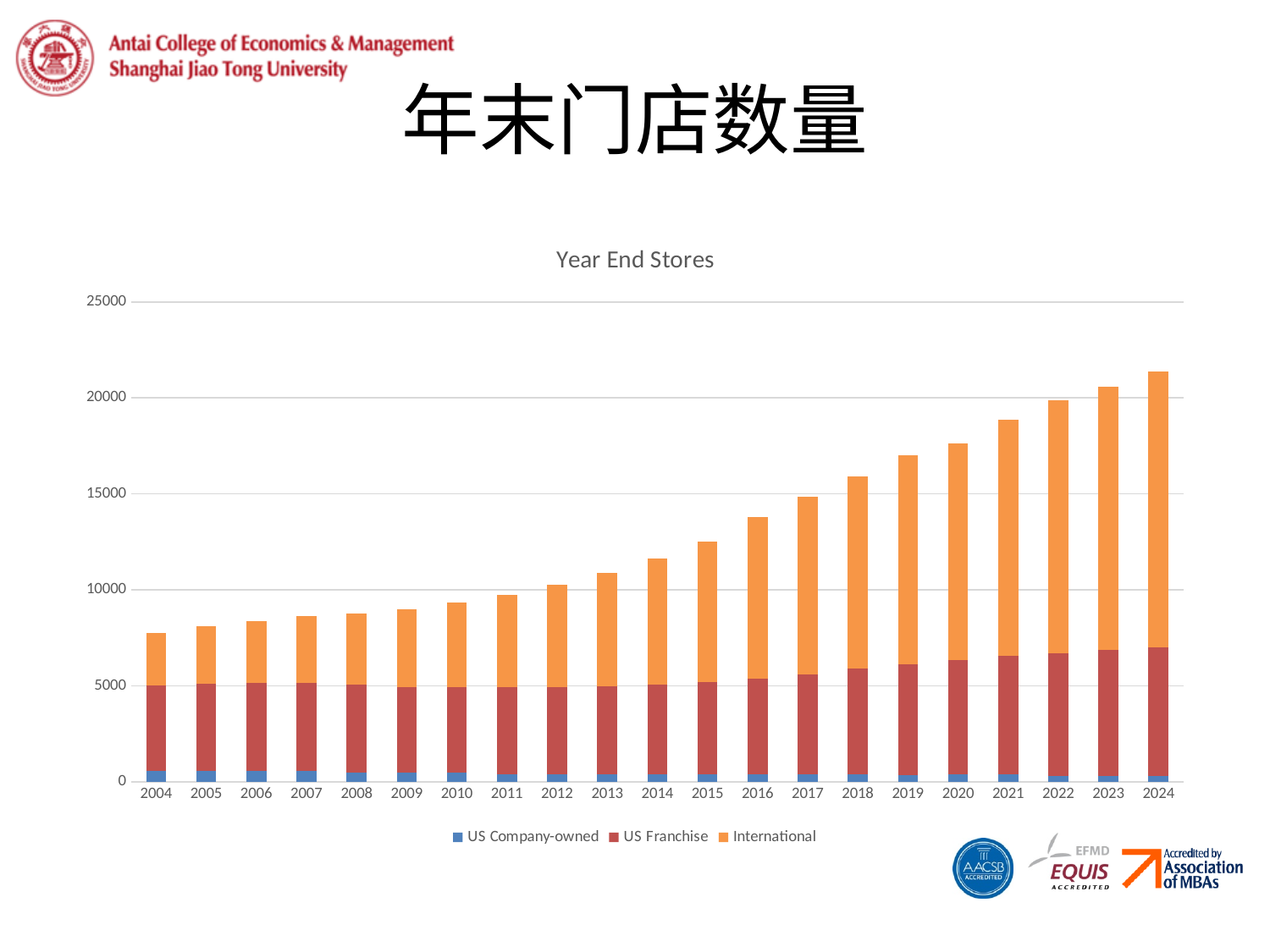
Do the total year-end store counts rise or fall from 2004 to 2024? rise Which year has the lowest total number of year-end stores? 2004 What is the title of the chart? Year End Stores Is the total value for 2018 greater or less than 15000? greater How many years are shown on the x axis? 21 Is the total value for 2021 greater or less than 20000? less How many series does the legend list? 3 Is the total value for 2004 greater or less than 10000? less Which series is shown in orange in the legend? International What kind of chart is shown on the slide? stacked bar chart Which year has the highest total number of year-end stores? 2024